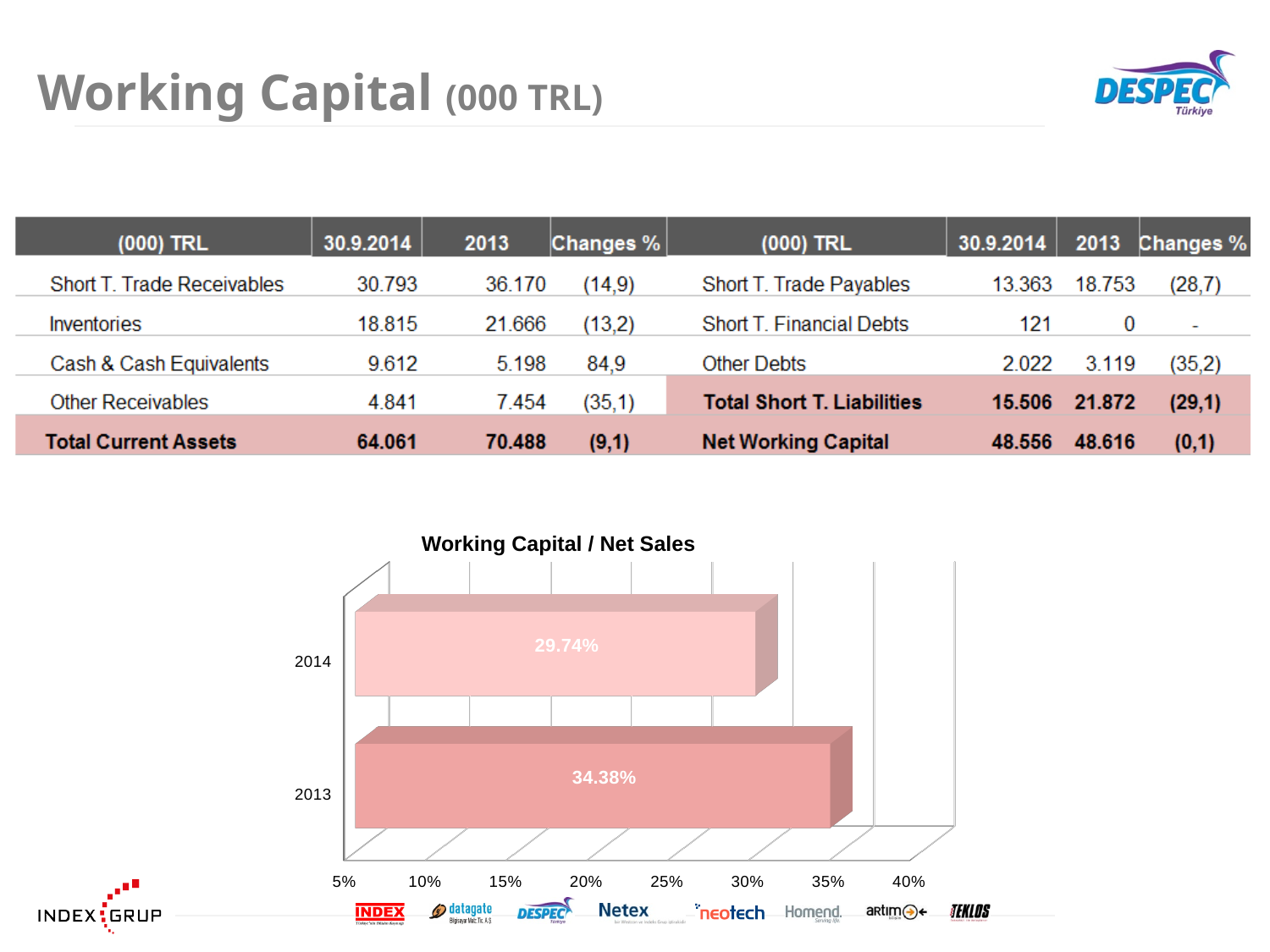
Is the value for 2013 in the Working Capital / Net Sales chart greater or less than 30%? greater What is the value for 2014 in the Working Capital / Net Sales chart? 29.74% What is the title of the chart on the slide? Working Capital / Net Sales Which year has the lower Working Capital / Net Sales ratio? 2014 What is the value for 2013 in the Working Capital / Net Sales chart? 34.38% Is the value for 2014 in the Working Capital / Net Sales chart greater or less than 25%? greater What is the difference between the 2013 and 2014 values in the Working Capital / Net Sales chart? 4.64% What kind of chart is the Working Capital / Net Sales chart? bar chart How many years are shown in the Working Capital / Net Sales chart? 2 Which year has the higher Working Capital / Net Sales ratio? 2013 Is the Working Capital / Net Sales value larger for 2014 or for 2013? 2013 Did the Working Capital / Net Sales ratio rise or fall from 2013 to 2014? fall